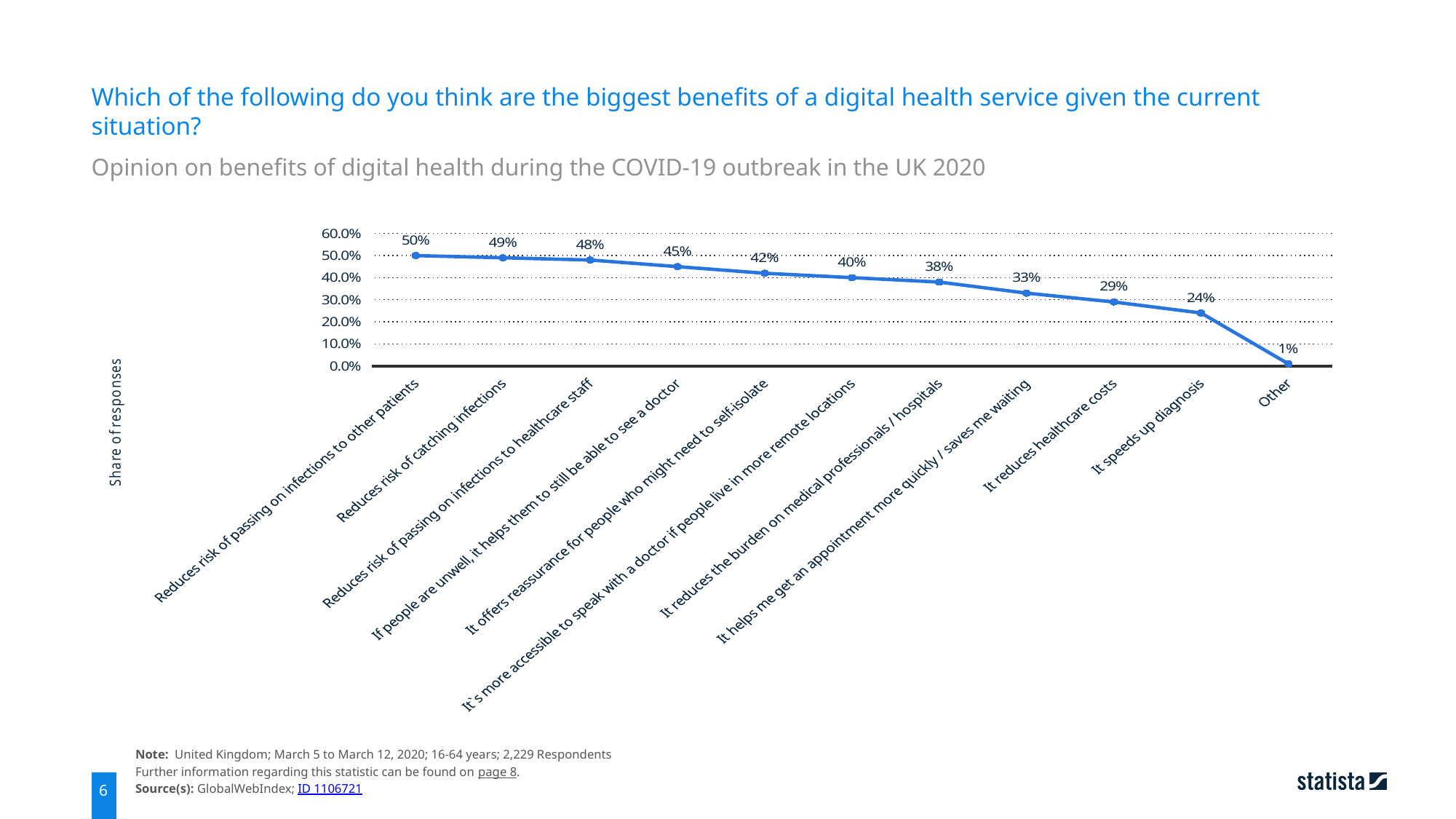
What kind of chart is shown on the slide? Line chart Is the value for "It offers reassurance for people who might need to self-isolate" greater or less than 40.0%? greater What is the label of the vertical axis? Share of responses What share of respondents chose "It reduces healthcare costs"? 29% Which category has the highest share of responses? Reduces risk of passing on infections to other patients What share of respondents chose "Reduces risk of catching infections"? 49% Which category has the lowest share of responses? Other What share of respondents chose "It speeds up diagnosis"? 24% Do the values rise or fall from left to right along the x axis? Fall What is the difference between the share for "Reduces risk of passing on infections to other patients" and the share for "Other"? 49% Which is larger: the share for "It reduces the burden on medical professionals / hospitals" or the share for "It reduces healthcare costs"? It reduces the burden on medical professionals / hospitals How many categories are plotted on the chart? 11